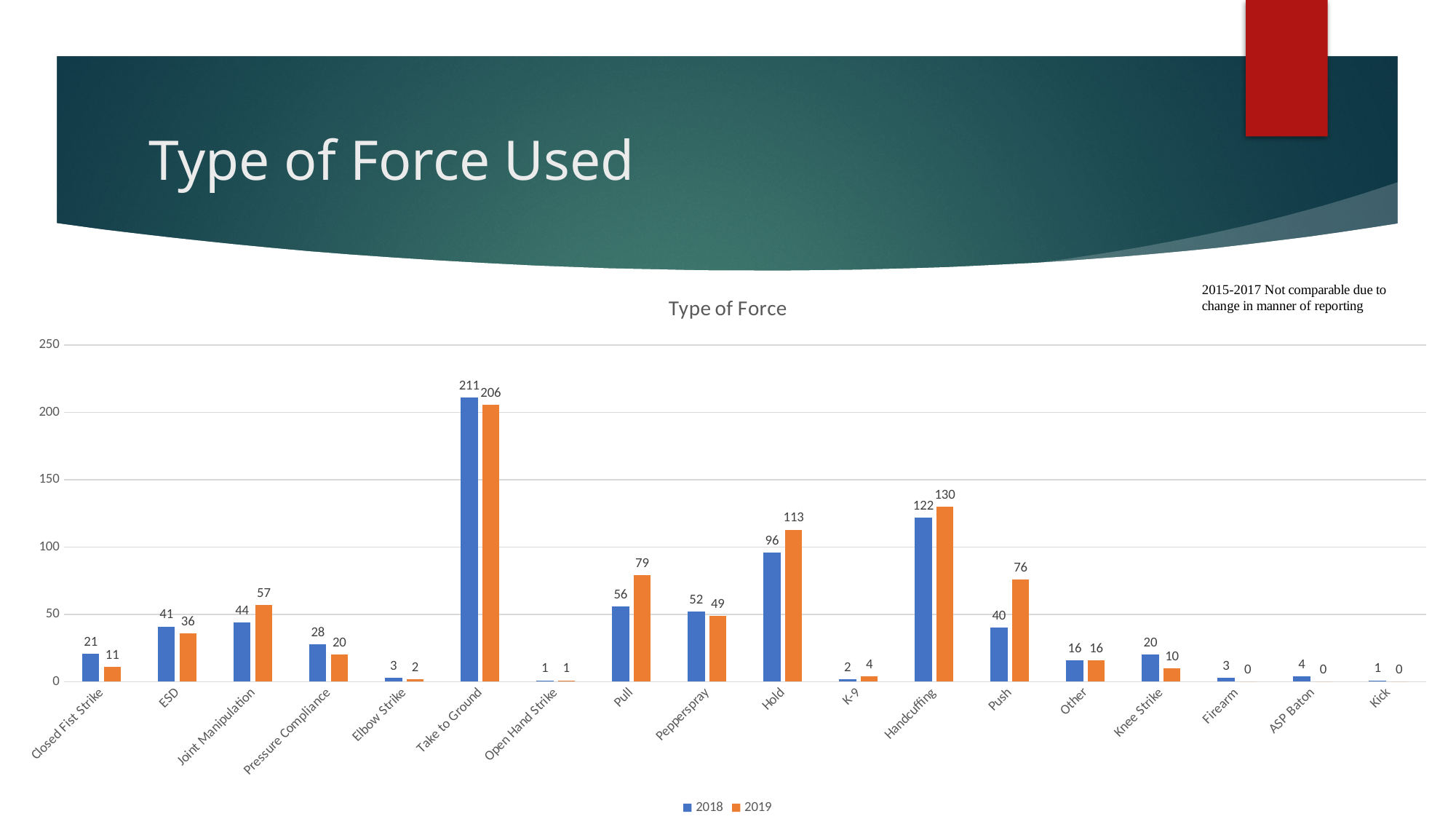
What is the title of the chart? Type of Force What is the 2019 value for Pull? 79 How many categories are shown on the x axis? 18 Is the 2018 value for Handcuffing greater or less than 100? greater What is the 2019 value for Handcuffing? 130 What kind of chart is shown? bar chart How many series does the legend list? 2 What is the difference between the 2018 and 2019 values for Hold? 17 Which category has the highest 2019 value? Take to Ground What is the 2018 value for Take to Ground? 211 Which is larger for Joint Manipulation, the 2018 value or the 2019 value? 2019 Which category has the lowest 2018 value? Open Hand Strike and Kick